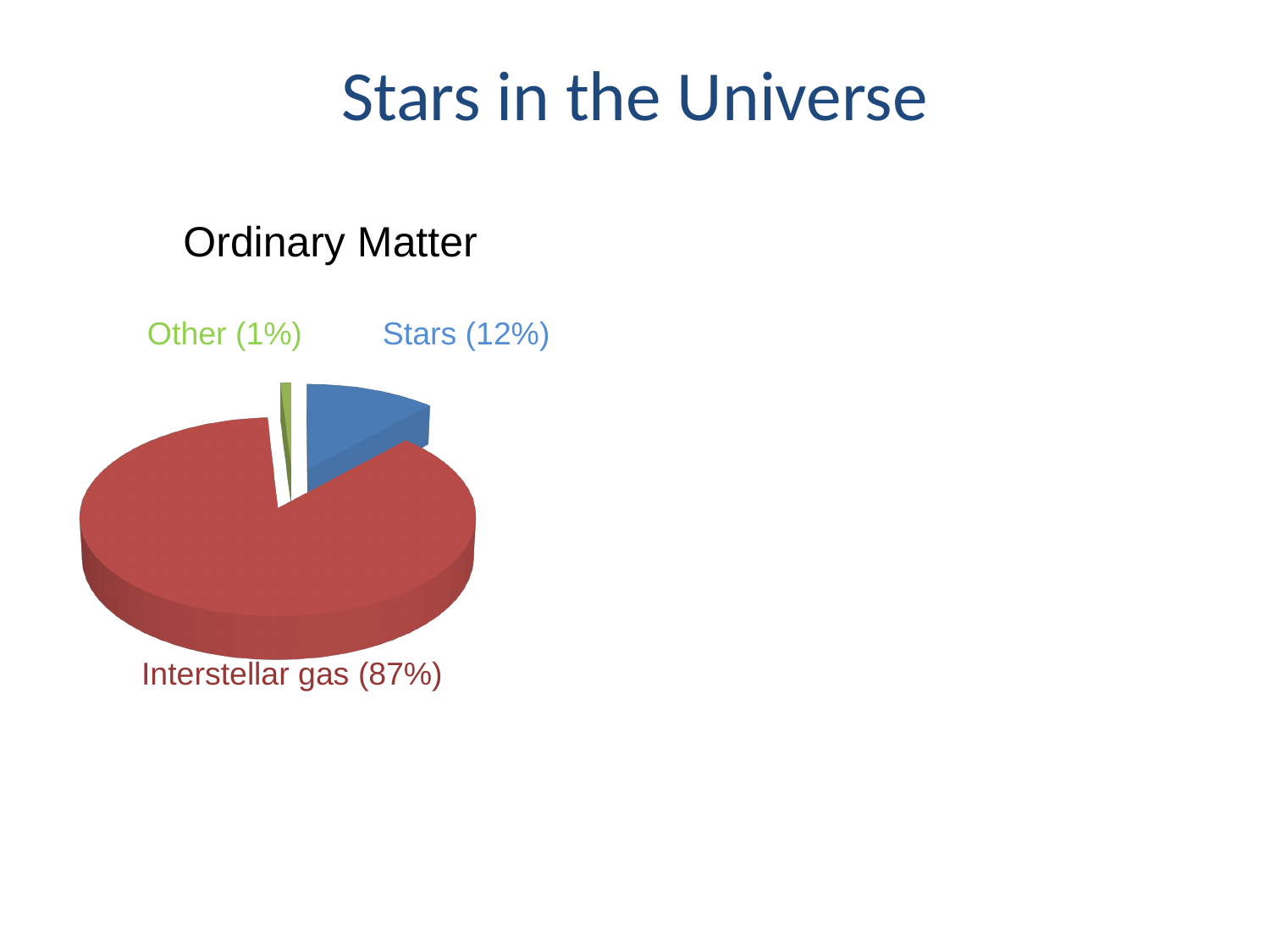
What is the combined share of Stars and Other? 13% Which is larger, the share for Stars or the share for Other? Stars Which slice of the pie chart is the largest? Interstellar gas What is the title of the pie chart? Ordinary Matter What share of ordinary matter is labelled Other? 1% What is the difference in percentage points between the interstellar gas share and the stars share? 75 Which slice of the pie chart is the smallest? Other What share of ordinary matter is stars? 12% What kind of chart is shown on the slide? Pie chart What colour is the Interstellar gas slice? Red What share of ordinary matter is interstellar gas? 87% How many slices does the pie chart have? 3